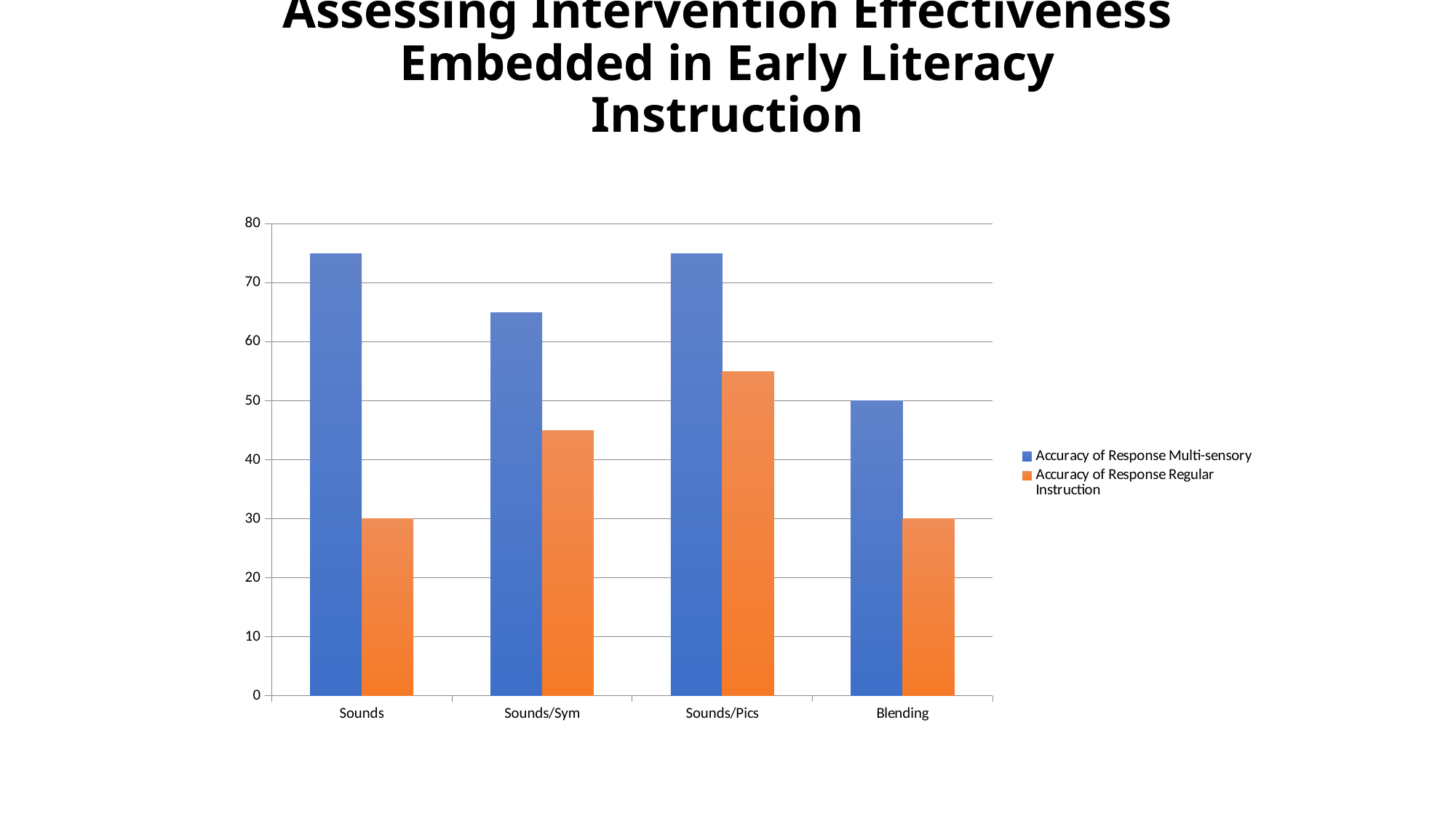
Which category has the lowest Accuracy of Response Multi-sensory value? Blending What is the Accuracy of Response Regular Instruction value for Sounds? 30 For Blending, what is the difference between the Multi-sensory and Regular Instruction values? 20 For Sounds, which is larger: the Multi-sensory value or the Regular Instruction value? Multi-sensory What is the Accuracy of Response Regular Instruction value for Blending? 30 What is the Accuracy of Response Multi-sensory value for Blending? 50 Which category has the highest Accuracy of Response Regular Instruction value? Sounds/Pics What type of chart is shown on the slide? bar chart Is the Accuracy of Response Regular Instruction value for Sounds/Sym greater or less than 40? greater Is the Accuracy of Response Multi-sensory value for Sounds/Pics greater or less than 70? greater How many series does the legend list? 2 How many categories are shown on the x axis? 4